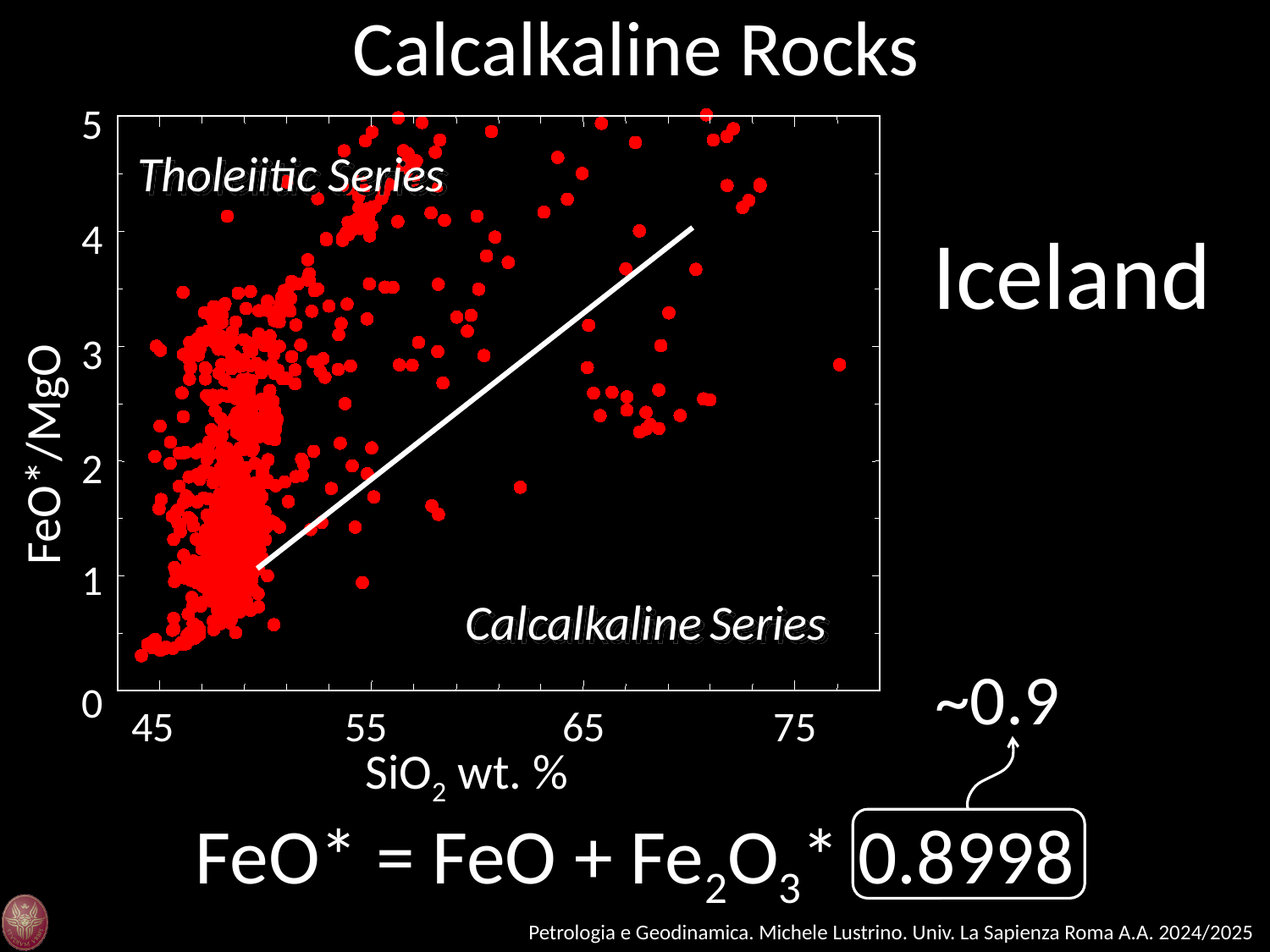
What quantity is plotted on the x axis of the chart? SiO2 wt. % Does the white dividing line rise or fall as SiO2 increases? Rises What is the title of the chart? Calcalkaline Rocks What is the lowest SiO2 tick value shown on the x axis? 45 Which region of the chart is labelled below the white dividing line? Calcalkaline Series Is the densest cluster of data points located at SiO2 values less or greater than 55 wt. %? less What kind of chart is shown on the slide? Scatter plot Which series field contains most of the plotted data points? Tholeiitic Series What is the highest value shown on the y axis? 5